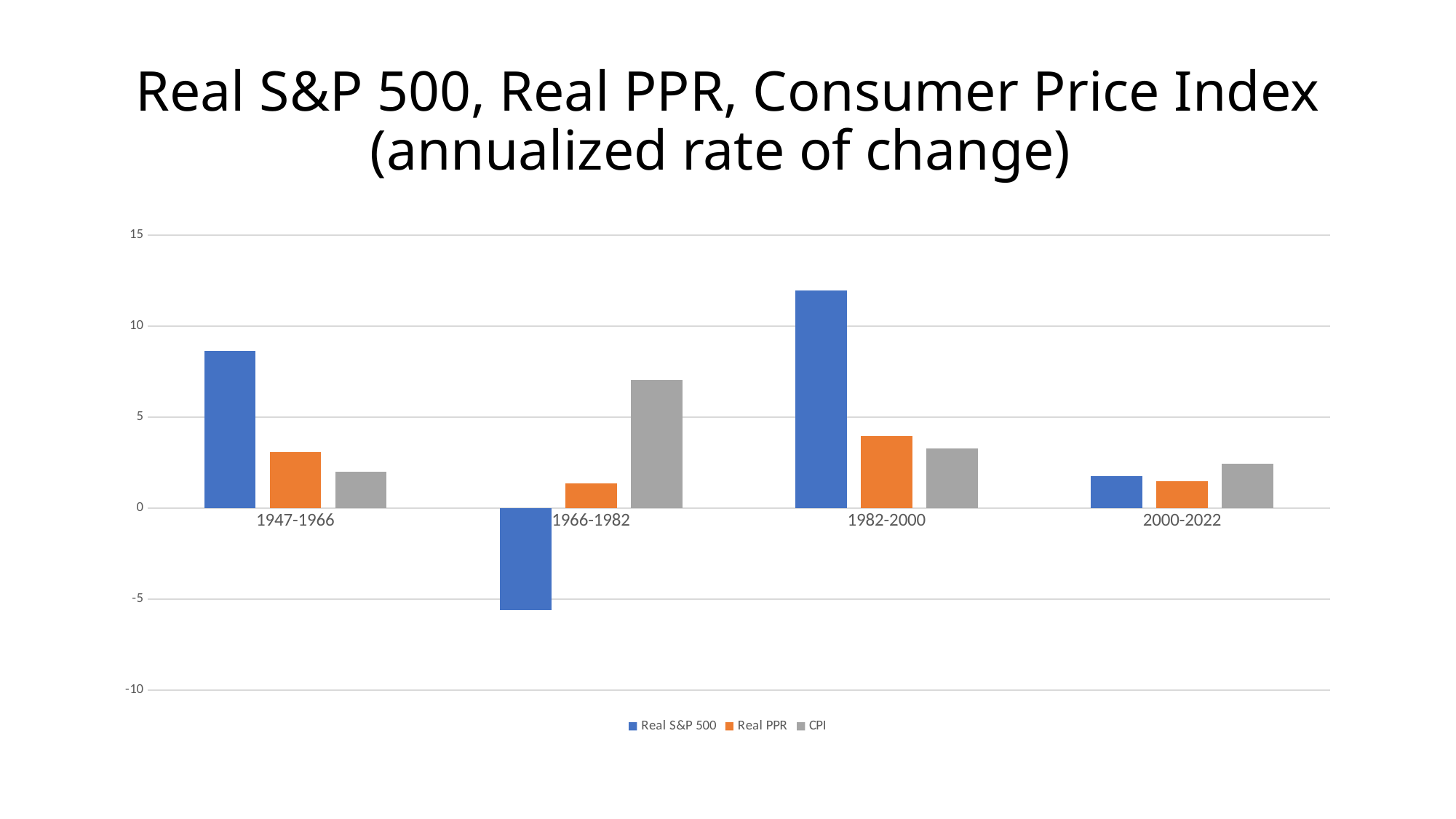
Is the Real S&P 500 value for 1966-1982 greater or less than -5? less For 1947-1966, which is larger: Real S&P 500 or Real PPR? Real S&P 500 Is the Real S&P 500 value for 1982-2000 greater or less than 10? greater Is the CPI value for 1966-1982 greater or less than 5? greater In which period is the CPI value highest? 1966-1982 For 1966-1982, which is larger: CPI or Real PPR? CPI In which period is the Real S&P 500 value lowest? 1966-1982 What kind of chart is shown on the slide? Bar chart How many series does the legend list? 3 What colour represents CPI in the legend? Grey How many time periods are shown on the x axis? 4 In which period is the Real S&P 500 value highest? 1982-2000